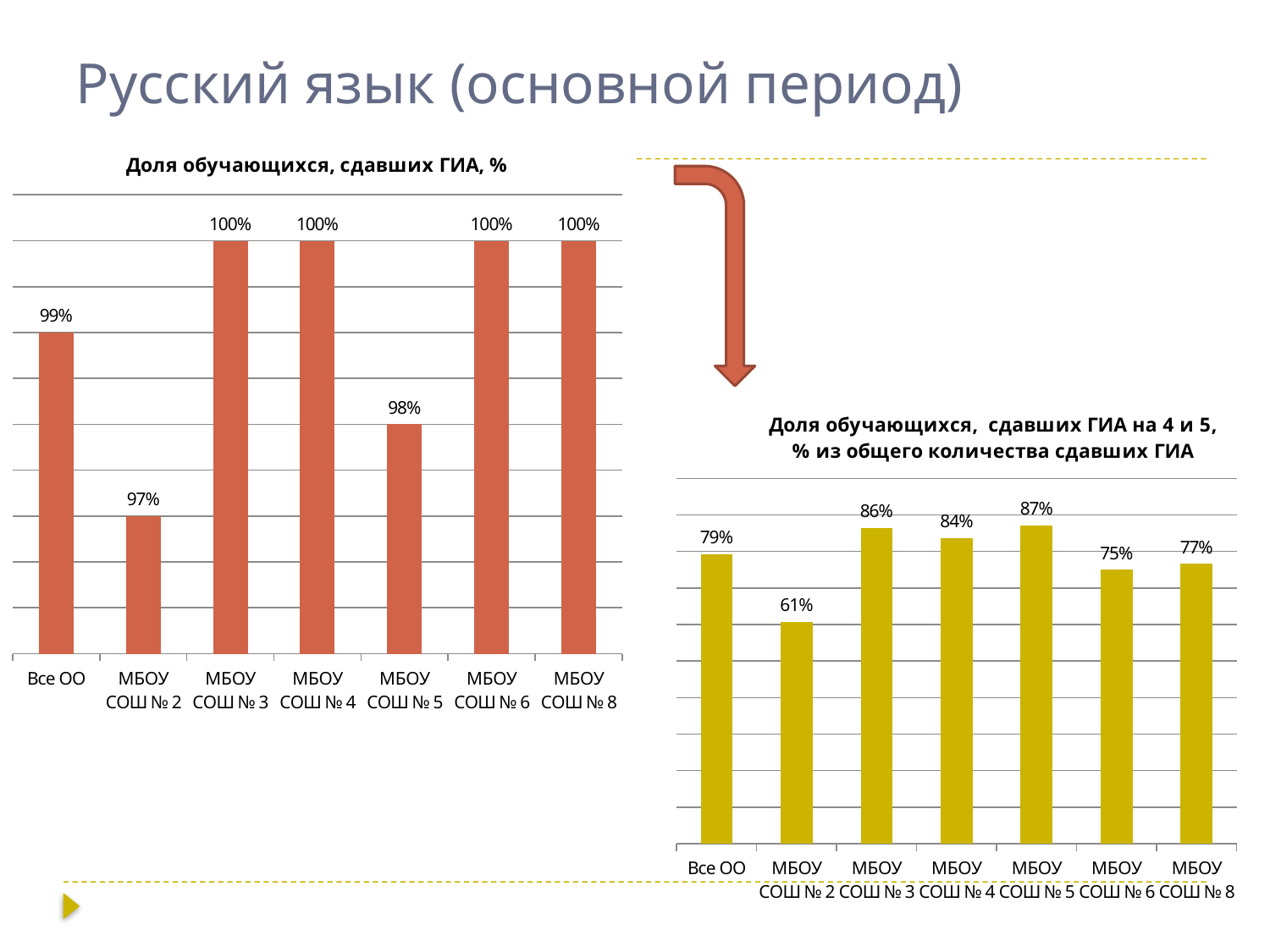
In the chart 'Доля обучающихся, сдавших ГИА на 4 и 5', what is the value for МБОУ СОШ № 6? 75% In the chart 'Доля обучающихся, сдавших ГИА на 4 и 5', what is the difference between the values for МБОУ СОШ № 3 and Все ОО? 7% In the chart 'Доля обучающихся, сдавших ГИА, %', what is the value for Все ОО? 99% What type of chart is the chart on the right of the slide? Bar chart In the chart 'Доля обучающихся, сдавших ГИА на 4 и 5', which category has the highest value? МБОУ СОШ № 5 In the chart 'Доля обучающихся, сдавших ГИА на 4 и 5', what is the value for МБОУ СОШ № 2? 61% In the chart 'Доля обучающихся, сдавших ГИА на 4 и 5', which is larger: the value for МБОУ СОШ № 8 or МБОУ СОШ № 6? МБОУ СОШ № 8 In the chart 'Доля обучающихся, сдавших ГИА, %', what is the difference between the values for МБОУ СОШ № 5 and МБОУ СОШ № 2? 1% In the chart 'Доля обучающихся, сдавших ГИА, %', what is the value for МБОУ СОШ № 2? 97% In the chart 'Доля обучающихся, сдавших ГИА, %', which category has the lowest value? МБОУ СОШ № 2 In the chart 'Доля обучающихся, сдавших ГИА, %', how many categories are shown on the x axis? 7 In the chart 'Доля обучающихся, сдавших ГИА на 4 и 5', which category has the lowest value? МБОУ СОШ № 2